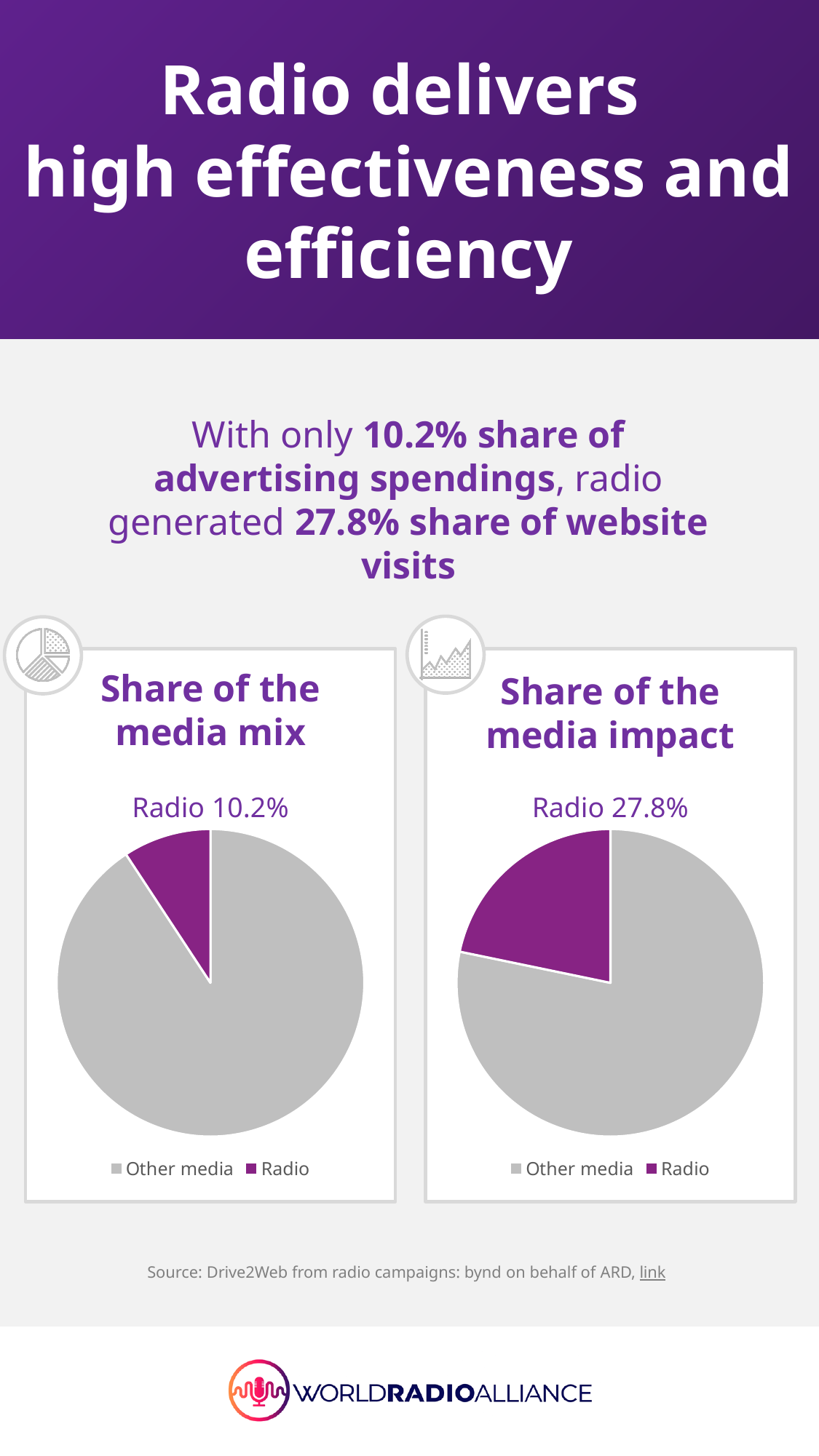
In the "Share of the media impact" chart, what is the value for Radio? 27.8% How many slices does the "Share of the media impact" pie chart have? 2 In the "Share of the media impact" chart, which category has the smallest slice? Radio What colour is the Radio slice in the "Share of the media mix" chart? Purple Is the Radio share larger in the "Share of the media mix" chart or in the "Share of the media impact" chart? Share of the media impact How many entries does the legend of the "Share of the media mix" chart list? 2 What kind of chart is the "Share of the media mix" chart? Pie chart What is the difference between the Radio share in the "Share of the media impact" chart and the Radio share in the "Share of the media mix" chart? 17.6 percentage points In the "Share of the media mix" chart, which category has the largest slice? Other media In the "Share of the media mix" chart, what is the value for Radio? 10.2% What is the title of the pie chart on the right side of the slide? Share of the media impact In the "Share of the media impact" chart, which is larger, Other media or Radio? Other media